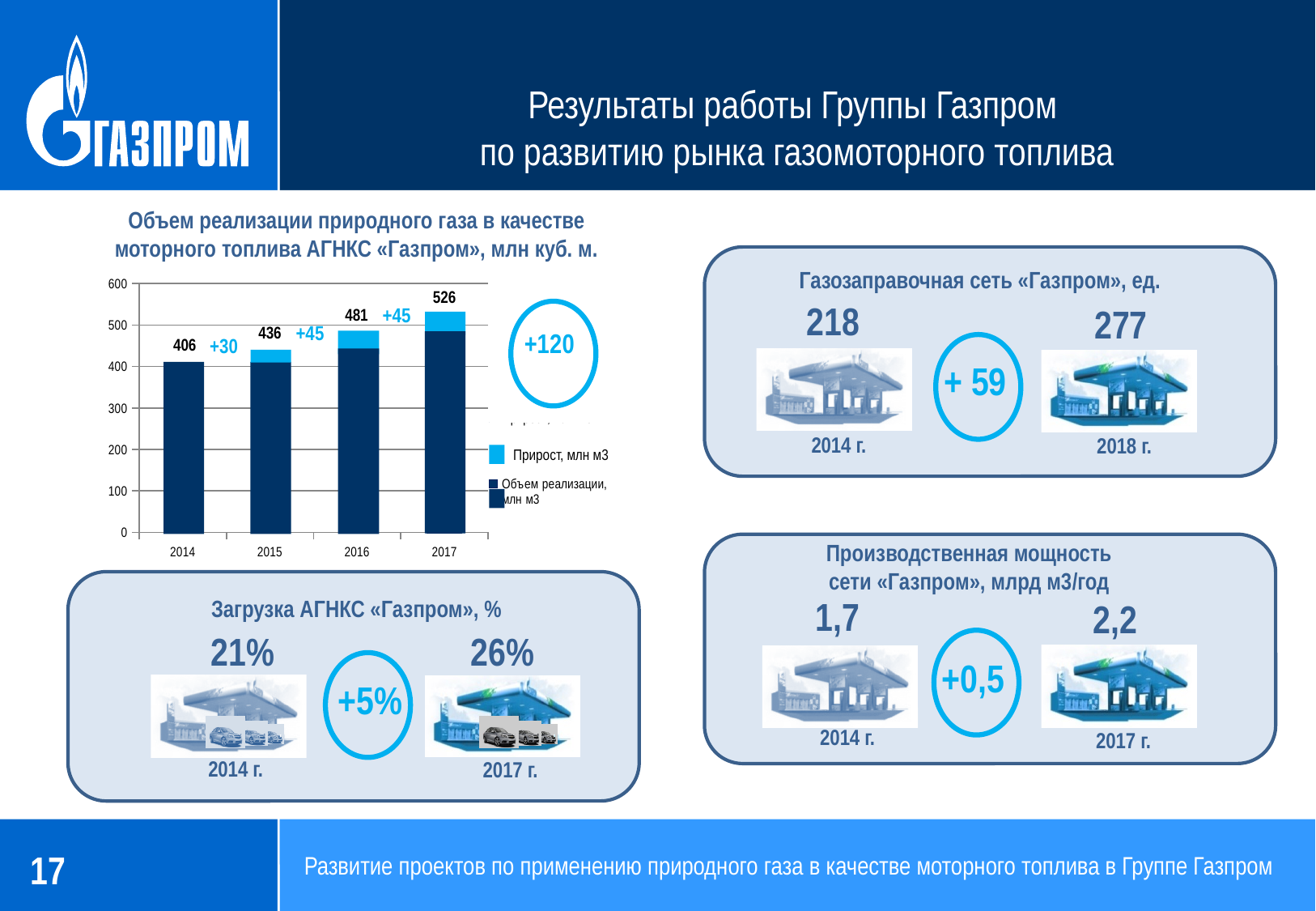
How many years are shown on the x axis of the chart of natural gas sales volume as motor fuel? 4 What is the total value shown for 2016 in the chart of natural gas sales volume as motor fuel? 481 What is the unit stated in the title of the chart of natural gas sales volume as motor fuel? млн куб. м What kind of chart is used to show natural gas sales volume as motor fuel? stacked bar chart What is the total value shown for 2015 in the chart of natural gas sales volume as motor fuel? 436 What is the difference between the 2017 total and the 2014 total in the chart of natural gas sales volume as motor fuel? 120 Which year has the lowest total in the chart of natural gas sales volume as motor fuel? 2014 In the chart of natural gas sales volume as motor fuel, is the total for 2016 larger or smaller than the total for 2015? larger What is the total value shown for 2014 in the chart of natural gas sales volume as motor fuel? 406 Which year has the highest total in the chart of natural gas sales volume as motor fuel? 2017 Do the totals in the chart of natural gas sales volume as motor fuel rise or fall from 2014 to 2017? rise What is the total value shown for 2017 in the chart of natural gas sales volume as motor fuel? 526